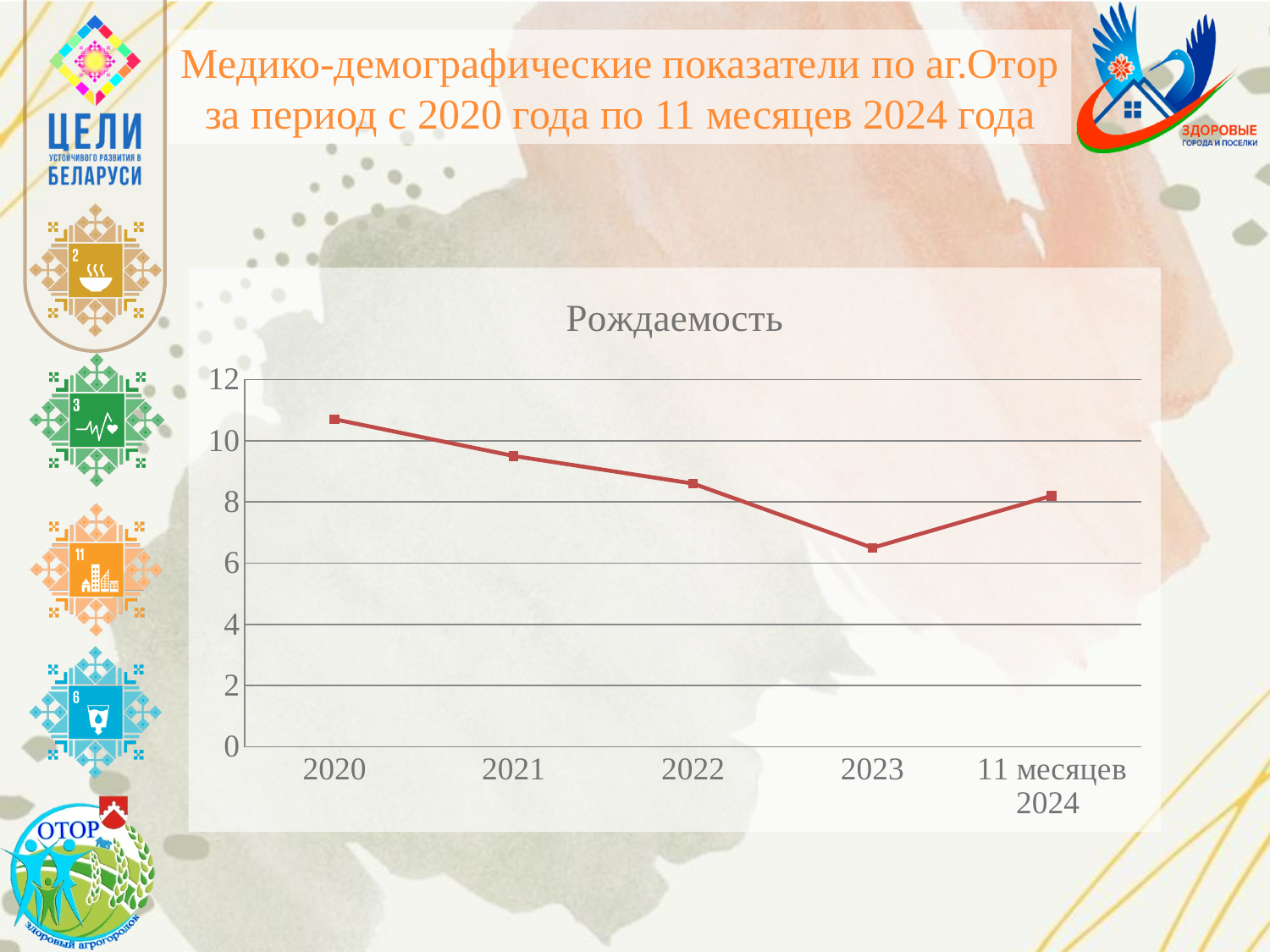
What is the first category on the x axis? 2020 Which period has the lowest value on the chart? 2023 What is the title of the chart? Рождаемость Do the values rise or fall from 2020 to 2023? fall Which is larger, the value for 2022 or the value for 2023? 2022 How many data points are plotted on the chart? 5 Which period has the highest value on the chart? 2020 Is the value for 2021 greater or less than 10? less What kind of chart is shown on the slide? line chart Is the value for 2020 greater or less than 10? greater Is the value for 2023 greater or less than 8? less